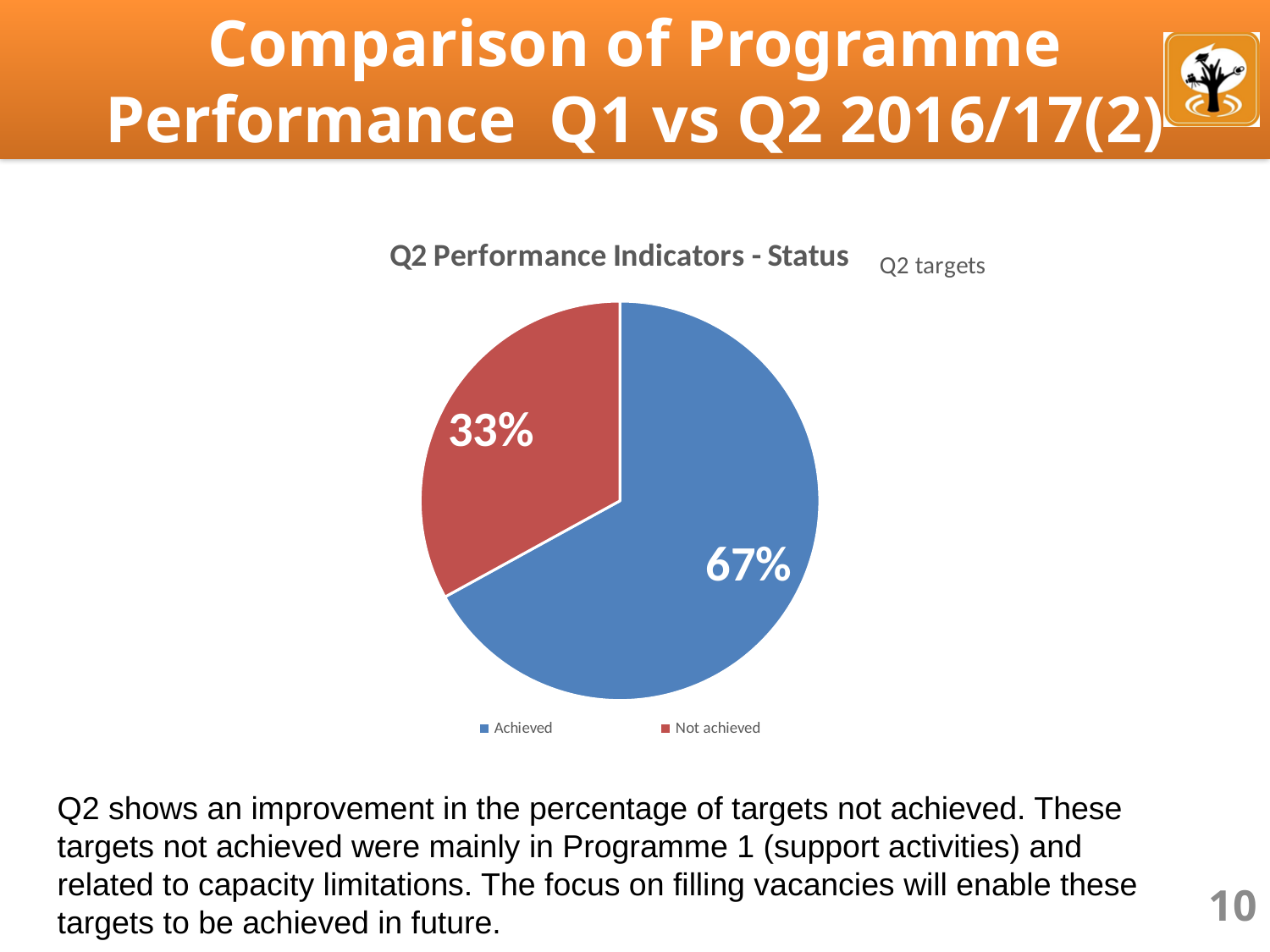
Which category has the smallest share of the pie? Not achieved Is the share for Achieved greater or less than 50%? greater How many slices does the pie chart have? 2 How many entries does the legend list? 2 What kind of chart is shown on the slide? pie chart What colour is the Not achieved slice? red Which category has the largest share of the pie? Achieved What percentage of Q2 performance indicators were not achieved? 33% What is the title of the chart? Q2 Performance Indicators - Status What is the difference in percentage points between the Achieved and Not achieved slices? 34 Which is larger, the share for Achieved or the share for Not achieved? Achieved What percentage of Q2 performance indicators were achieved? 67%